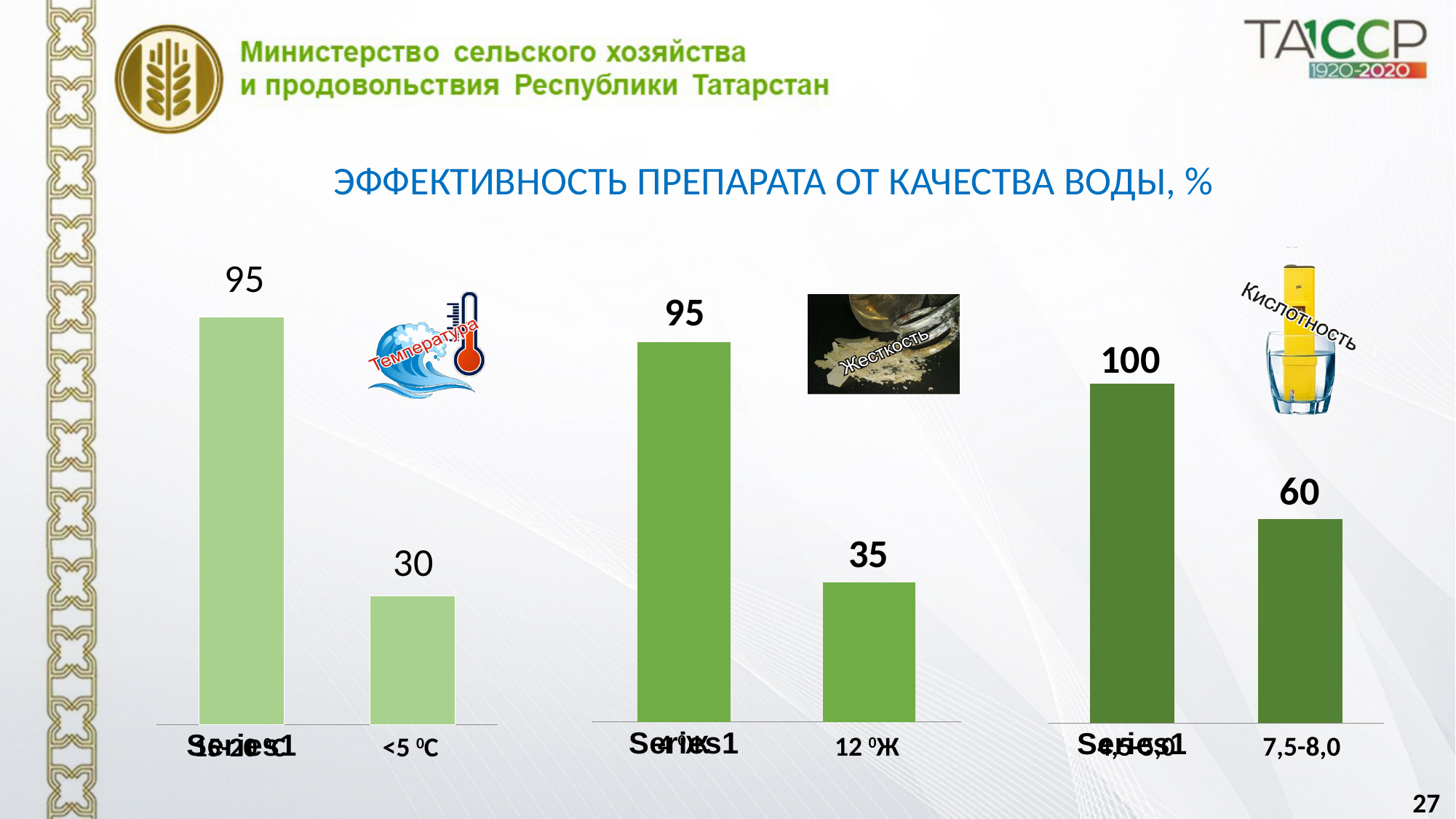
What type of chart is used on this slide? bar chart How many bars does the middle chart (Жесткость) have? 2 On the left chart (Температура), what is the value for the <5 °C bar? 30 On the right chart (Кислотность), what is the value of the left-hand bar? 100 On the middle chart (Жесткость), what is the value for the 12 °Ж bar? 35 What is the title of the slide above the charts? ЭФФЕКТИВНОСТЬ ПРЕПАРАТА ОТ КАЧЕСТВА ВОДЫ, % On the right chart (Кислотность), which bar is higher, the left-hand bar or the 7,5-8,0 bar? the left-hand bar On the middle chart (Жесткость), what is the difference between the two bars? 60 On the left chart (Температура), what is the value of the left-hand bar? 95 On the right chart (Кислотность), what is the difference between the left-hand bar and the 7,5-8,0 bar? 40 On the left chart (Температура), what is the difference between the left-hand bar and the <5 °C bar? 65 On the right chart (Кислотность), what is the value for the 7,5-8,0 bar? 60